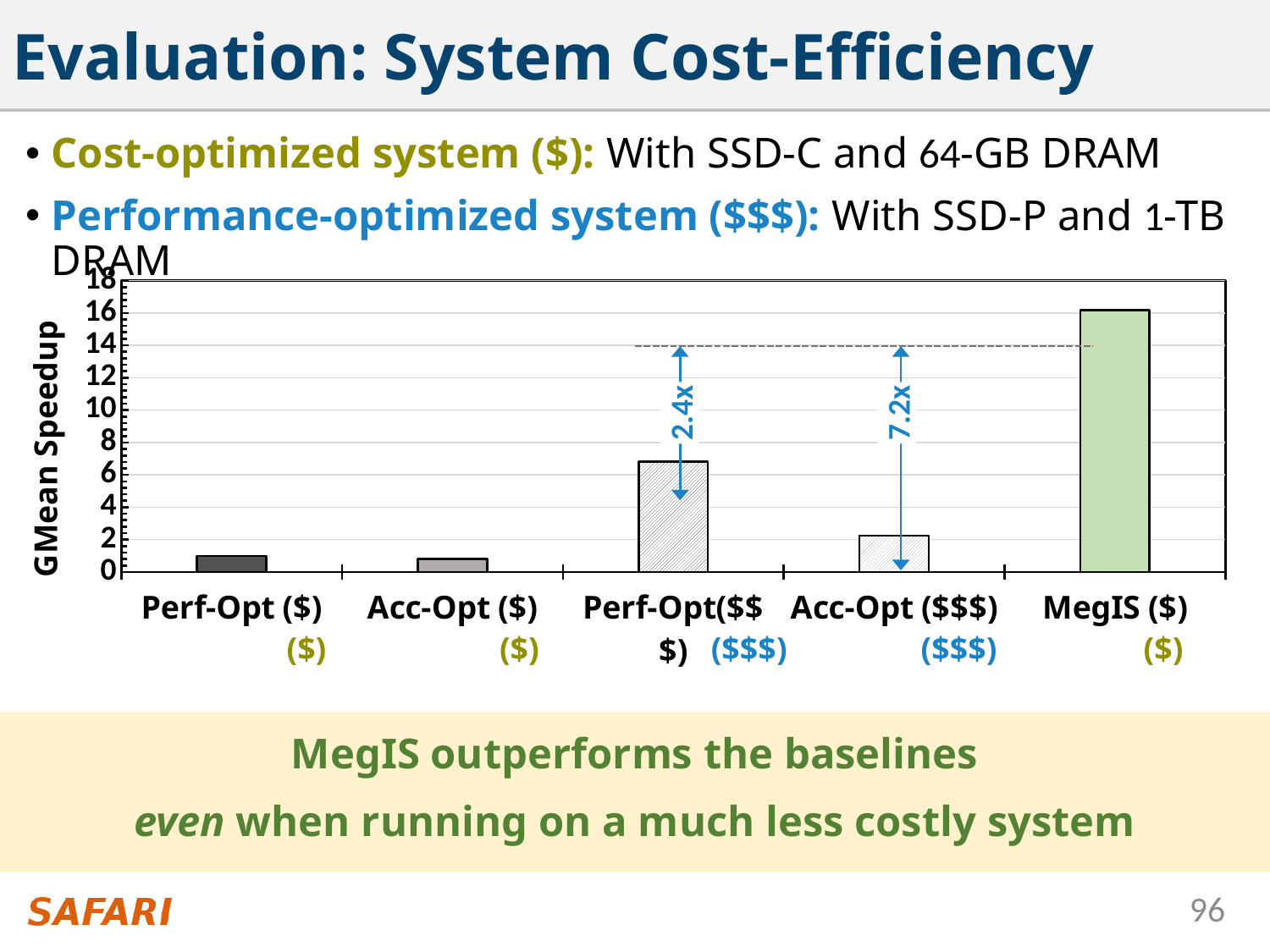
What kind of chart is shown on the slide? bar chart What is the label of the y-axis? GMean Speedup Which has a higher GMean Speedup, Perf-Opt($$$) or Acc-Opt ($$$)? Perf-Opt($$$) What speedup factor is annotated between Perf-Opt($$$) and MegIS ($)? 2.4x How many bars (categories) are plotted in the chart? 5 Is the GMean Speedup for Acc-Opt ($$$) greater or less than 4? less Which has a higher GMean Speedup, MegIS ($) or Perf-Opt($$$)? MegIS ($) Is the GMean Speedup for Perf-Opt($$$) greater or less than 6? greater Which category has the highest GMean Speedup? MegIS ($) What speedup factor is annotated between Acc-Opt ($$$) and MegIS ($)? 7.2x Is the GMean Speedup for Perf-Opt ($) greater or less than 2? less